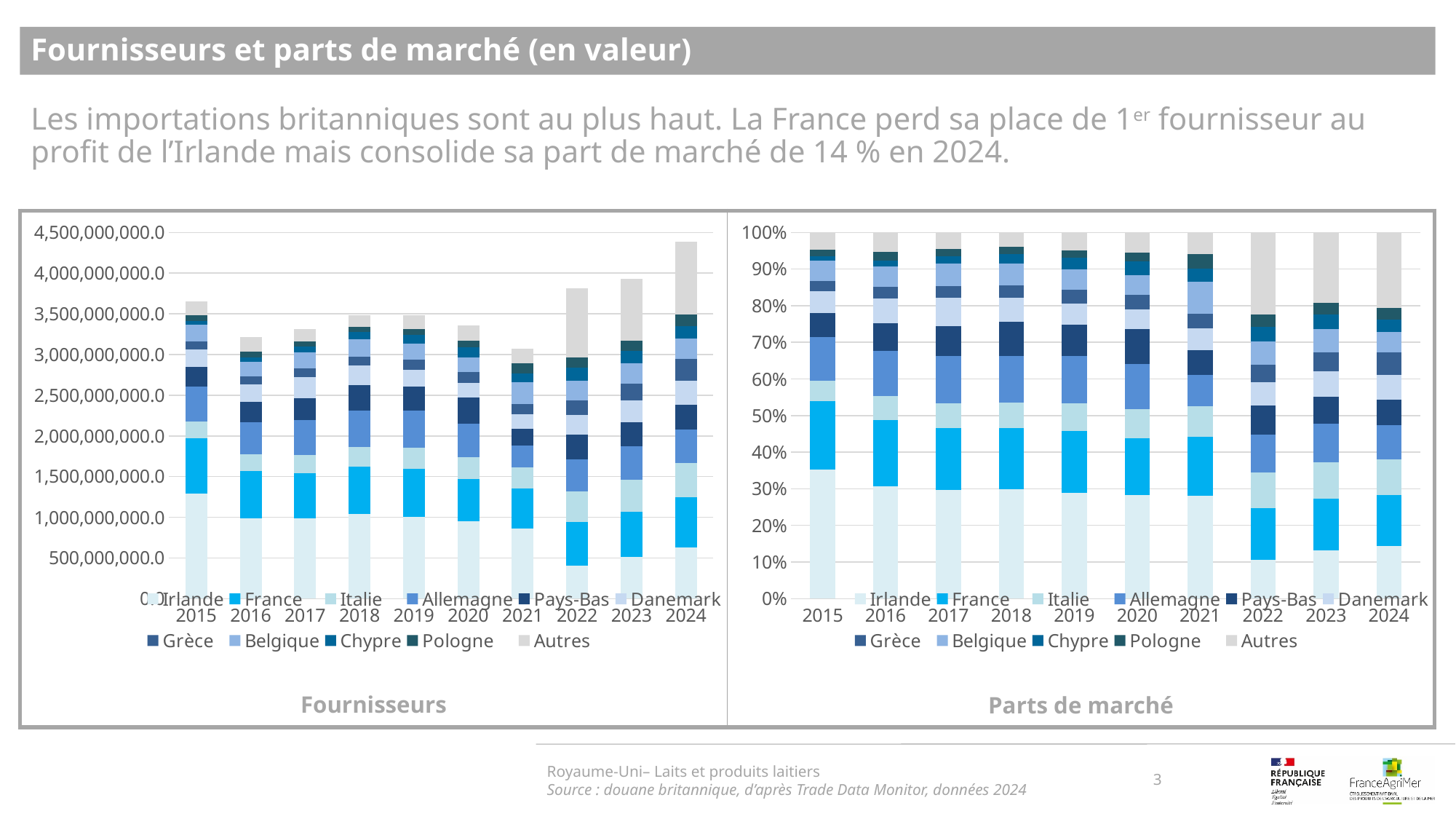
In the 'Fournisseurs' chart, is the total bar for 2021 greater or less than 3,500,000,000.0? less How many series does the legend of the 'Fournisseurs' chart list? 11 What kind of chart is the 'Fournisseurs' chart on the left? stacked bar chart In the 'Parts de marché' chart, does the Irlande share rise or fall from 2015 to 2024? fall How many years are shown on the x axis of the 'Parts de marché' chart? 10 In the 'Fournisseurs' chart for 2015, which segment is larger, Irlande or France? Irlande What is the title of the chart on the right? Parts de marché In the 'Parts de marché' chart, is the Irlande share for 2015 greater or less than 30%? greater Which legend entry is shown in light grey in both charts? Autres In the 'Fournisseurs' chart, is the total bar for 2024 greater or less than 4,000,000,000.0? greater In the 'Fournisseurs' chart, which year has the highest total bar? 2024